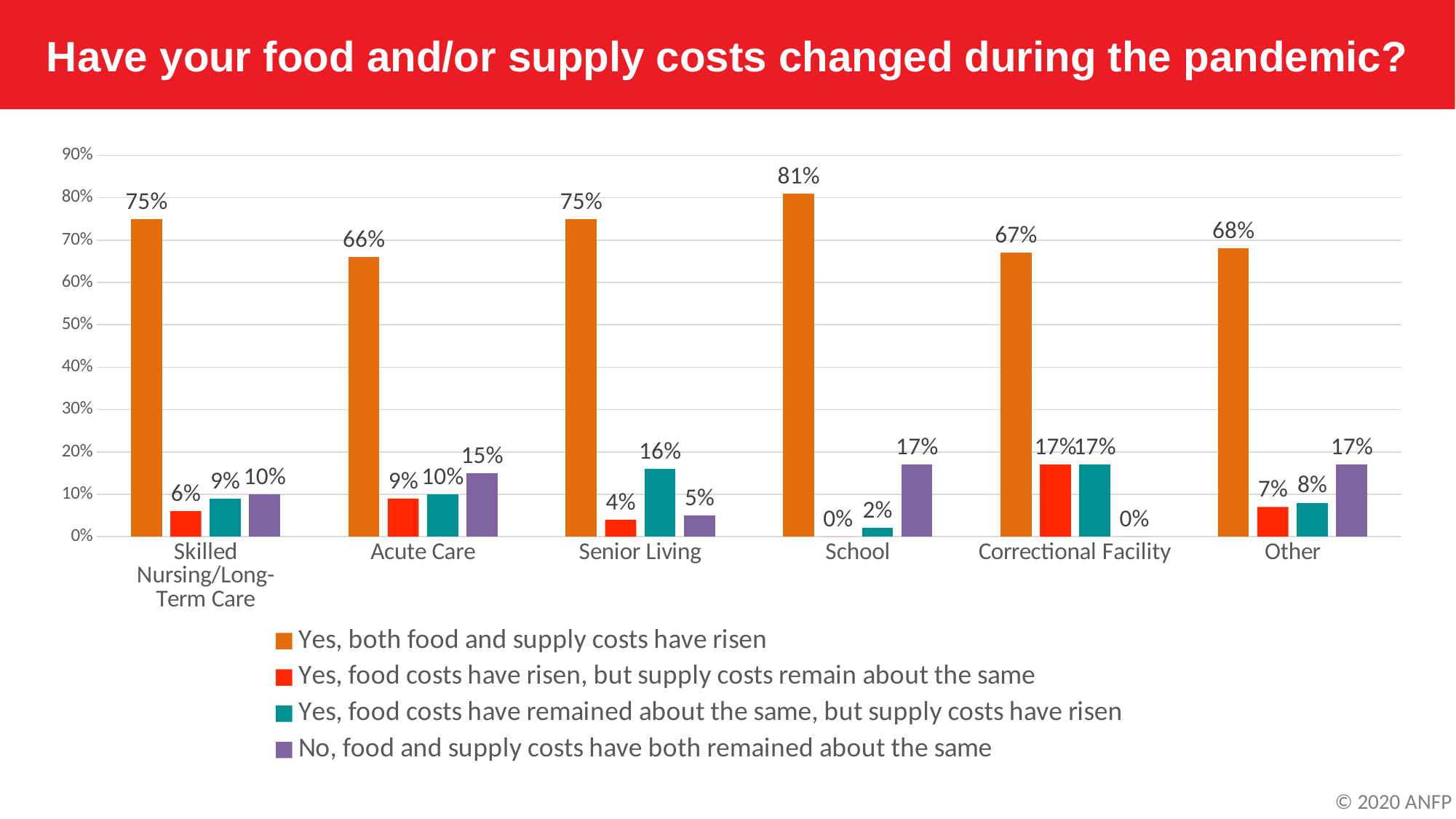
How many categories are shown on the x axis? 6 What kind of chart is shown on the slide? Bar chart Which category has the lowest value for 'Yes, both food and supply costs have risen'? Acute Care What is the value for Acute Care in the series 'No, food and supply costs have both remained about the same'? 15% What is the value for Senior Living in the series 'Yes, food costs have remained about the same, but supply costs have risen'? 16% What is the title of the chart? Have your food and/or supply costs changed during the pandemic? Which is larger: the Senior Living value or the Other value for 'Yes, both food and supply costs have risen'? Senior Living What is the difference between the School and Acute Care values for 'Yes, both food and supply costs have risen'? 15% What is the value for Correctional Facility in the series 'No, food and supply costs have both remained about the same'? 0% Which category has the highest value for 'Yes, both food and supply costs have risen'? School What percentage of School respondents said both food and supply costs have risen? 81% How many series does the legend list? 4